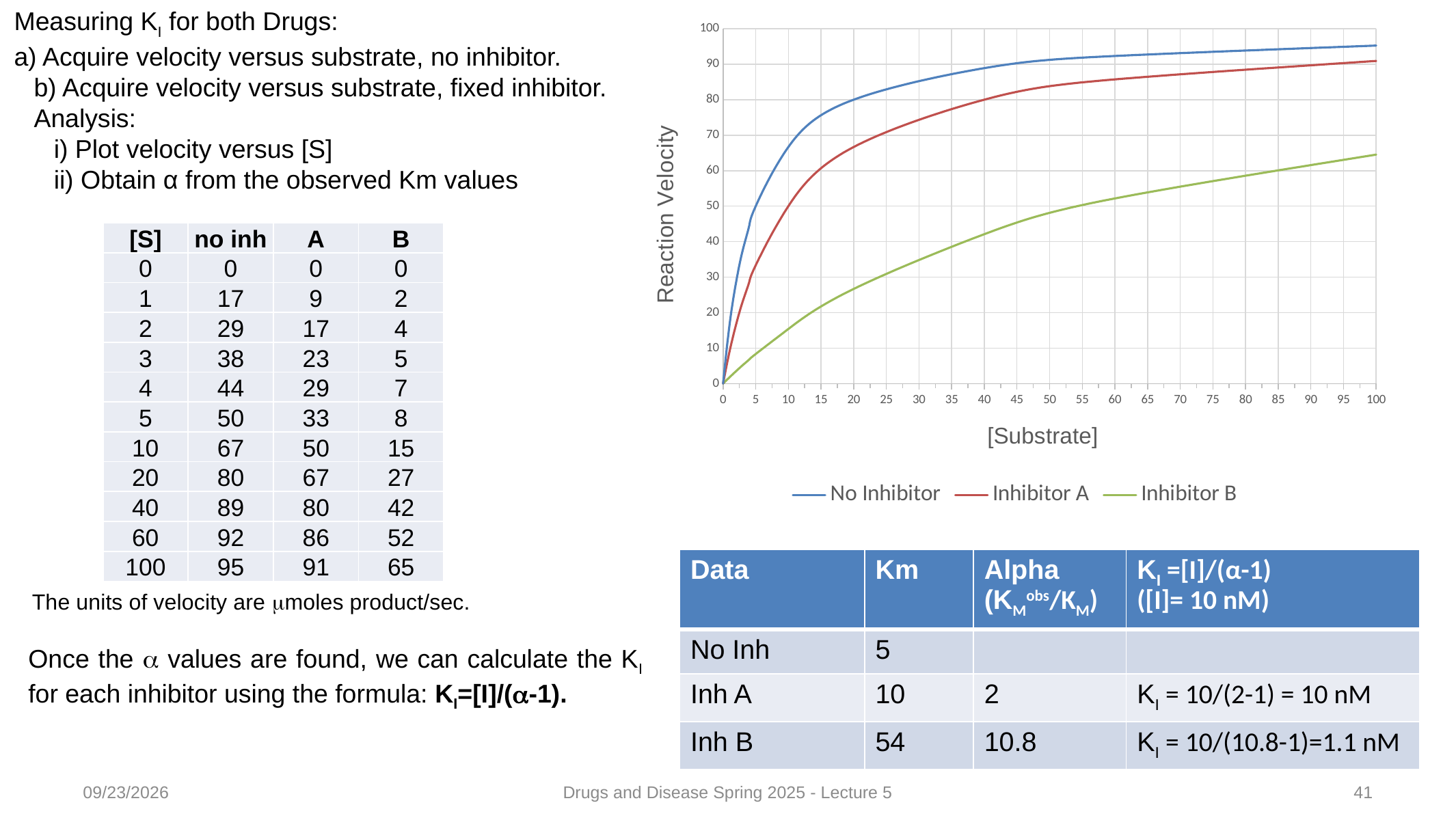
Is the Inhibitor A reaction velocity at [Substrate] = 10 greater or less than 40? greater Is the Inhibitor B reaction velocity at [Substrate] = 100 greater or less than 60? greater Which series has the lowest reaction velocity at [Substrate] = 40? Inhibitor B Which series has the highest reaction velocity at [Substrate] = 100? No Inhibitor At [Substrate] = 20, which is larger: the No Inhibitor velocity or the Inhibitor B velocity? No Inhibitor What are the three series named in the chart's legend? No Inhibitor, Inhibitor A, Inhibitor B Does the No Inhibitor curve rise or fall as [Substrate] increases? rises How many series does the chart's legend list? 3 According to the data table, what is the reaction velocity for Inhibitor B at [S] = 100? 65 Is the Inhibitor B reaction velocity at [Substrate] = 10 greater or less than 20? less What kind of chart is shown on the slide? line chart What is the label on the chart's vertical axis? Reaction Velocity